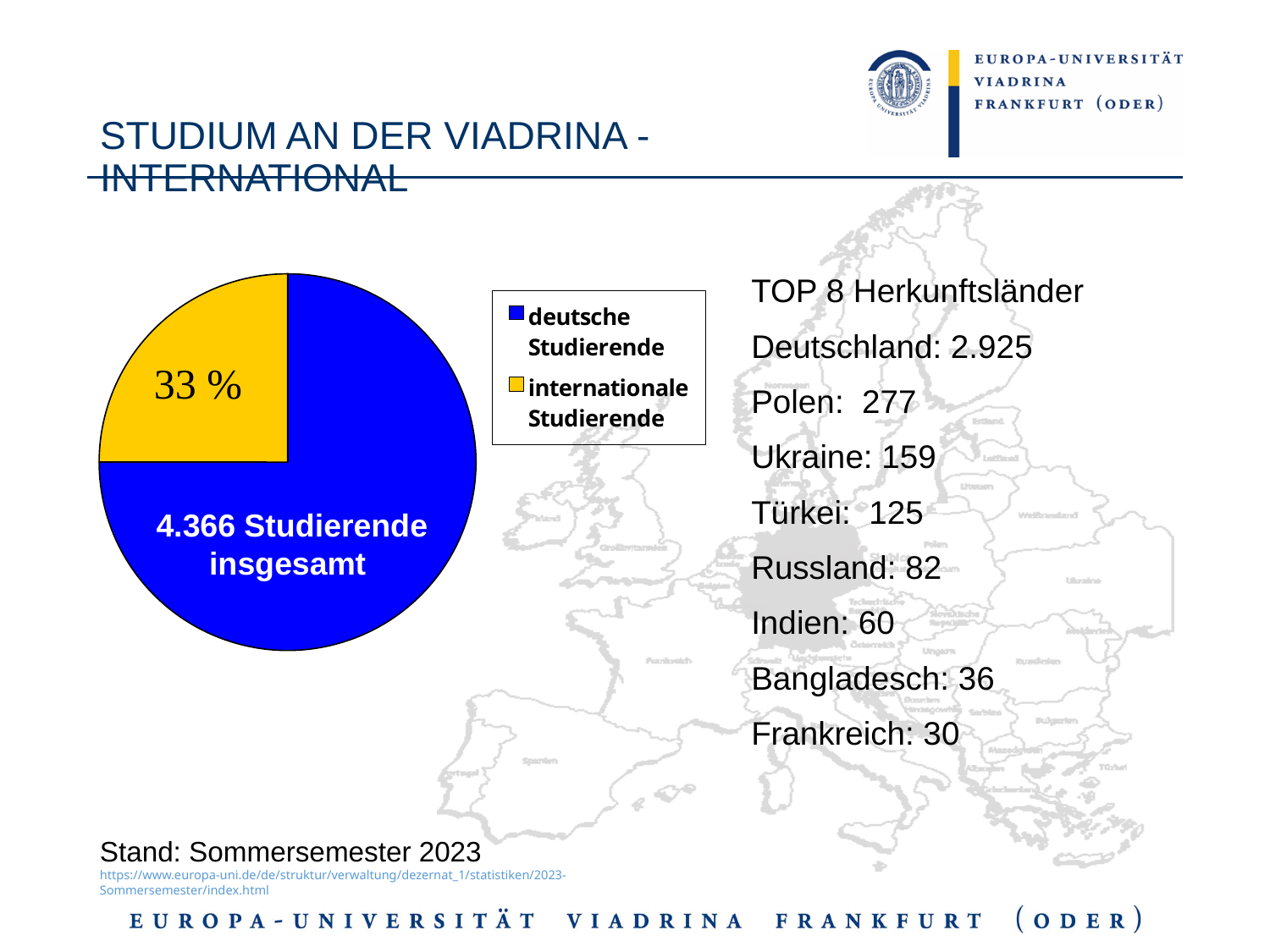
Is the share of internationale Studierende in the pie chart greater or less than 50 %? less What total number of students does the pie chart represent? 4.366 Studierende insgesamt Which slice of the pie chart is the smallest? internationale Studierende How many slices does the pie chart have? 2 What colour is the slice for deutsche Studierende in the pie chart? blue How many entries does the legend of the pie chart list? 2 What share of the pie chart do the internationale Studierende make up? 33 % What colour is the slice for internationale Studierende in the pie chart? yellow In the pie chart, which group is larger: deutsche Studierende or internationale Studierende? deutsche Studierende What kind of chart is shown on the slide? pie chart Which slice of the pie chart is the largest? deutsche Studierende